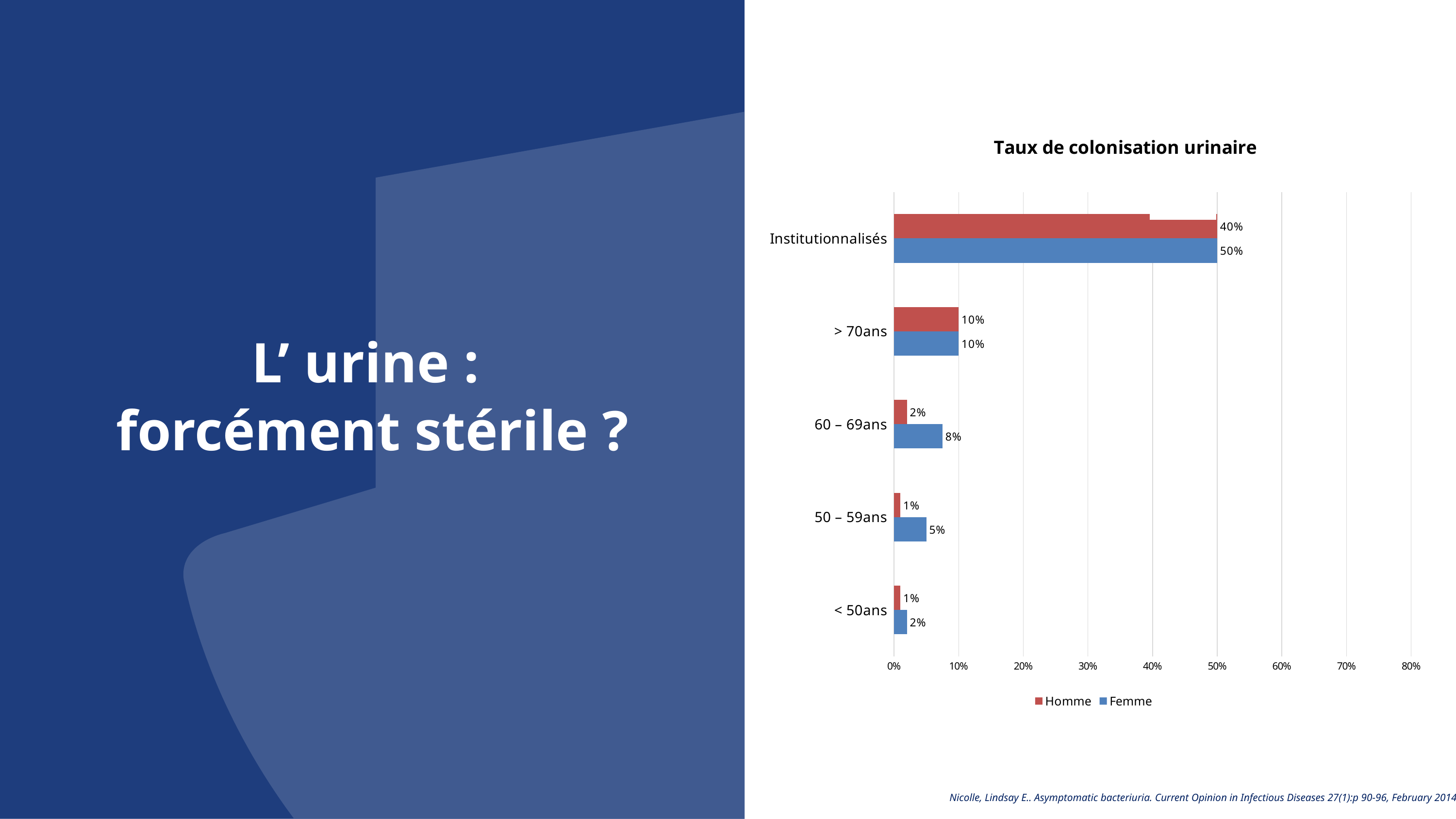
Which category has the lowest Femme value? < 50ans What kind of chart is shown on the slide? Bar chart How many categories are shown on the chart? 5 How many series does the legend list? 2 What is the difference between the Femme and Homme values for 60 – 69ans? 6% Which is larger for 50 – 59ans, the Homme value or the Femme value? Femme What is the Homme value for Institutionnalisés? 40% What is the title of the chart? Taux de colonisation urinaire What is the Femme value for 60 – 69ans? 8% Which category has the highest Femme value? Institutionnalisés What is the Homme value for 50 – 59ans? 1% What is the Femme value for Institutionnalisés? 50%